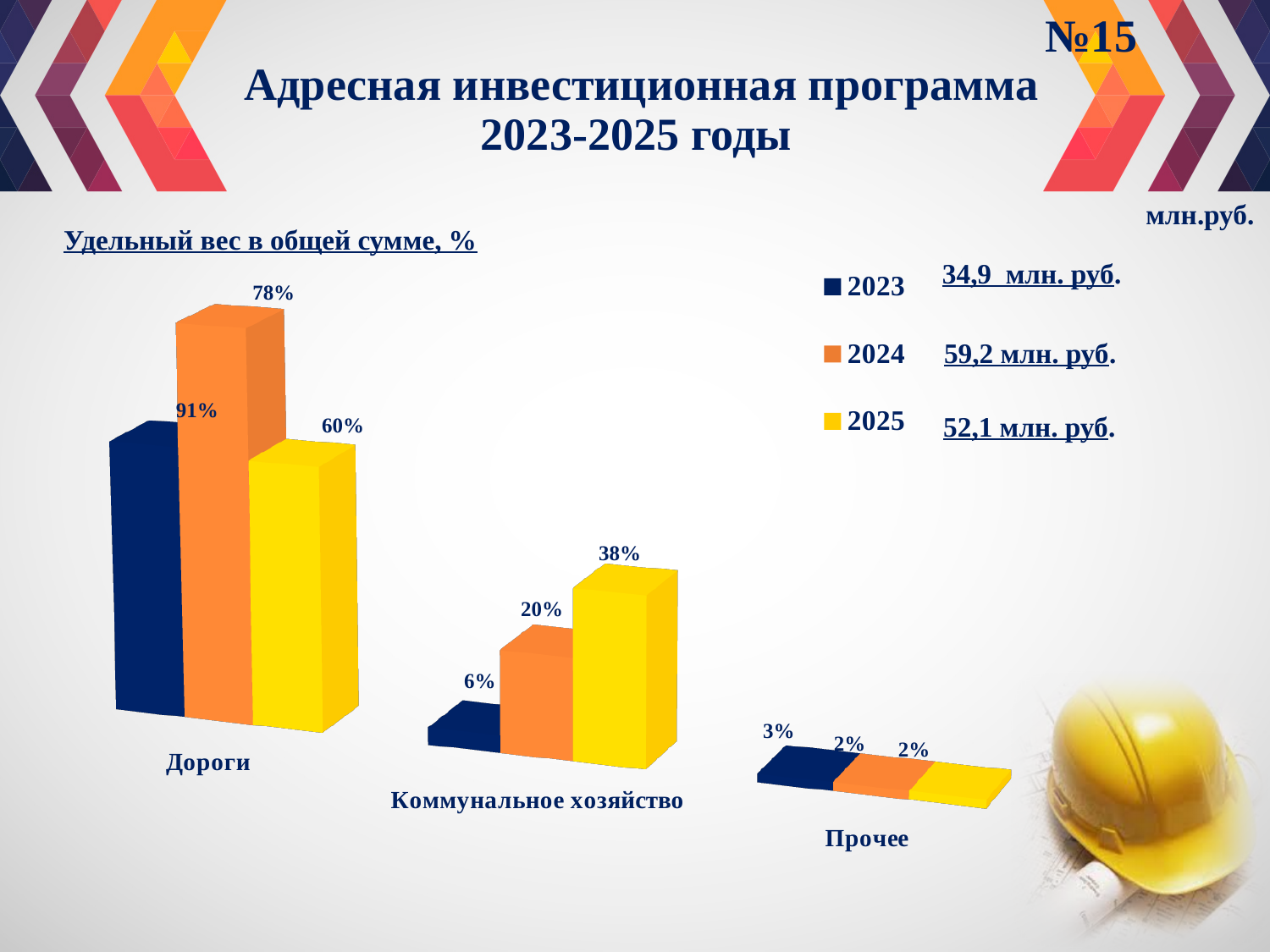
Which category has the lowest value in the 2025 series? Прочее What is the value for Дороги in the 2023 series? 91% What is the difference between the 2023 and 2025 values for Дороги? 31% Which is larger for Коммунальное хозяйство: the 2024 value or the 2025 value? 2025 What is the value for Прочее in the 2023 series? 3% What is the value for Коммунальное хозяйство in the 2025 series? 38% What is the value for Дороги in the 2025 series? 60% What is the difference between the 2025 and 2023 values for Коммунальное хозяйство? 32% How many series does the legend list? 3 Which category has the highest value in the 2024 series? Дороги What kind of chart is shown on the slide? Bar chart How many categories are shown on the x axis of the chart? 3